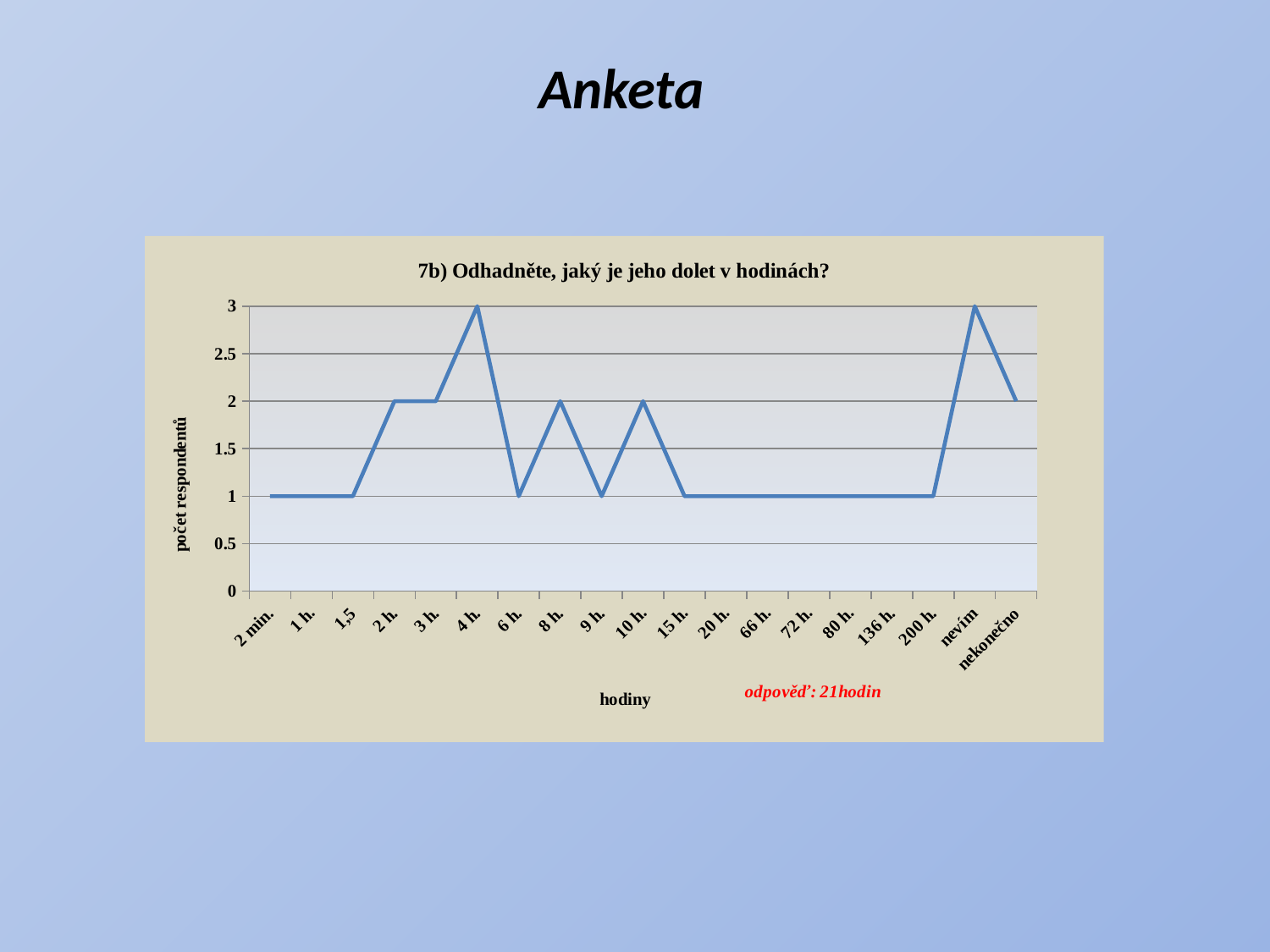
What type of chart is shown on the slide? line chart What is the value for the category "nevím"? 3 How many categories are shown on the x axis of the chart? 19 What is the title of the chart? 7b) Odhadněte, jaký je jeho dolet v hodinách? Which has the larger value, "2 h." or "6 h."? 2 h. What is the value for the category "6 h."? 1 What is the label of the y axis? počet respondentů What is the value for the category "2 h."? 2 What is the value for the category "4 h."? 3 What is the highest value plotted on the chart? 3 What is the difference between the values for "4 h." and "6 h."? 2 What is the value for the category "nekonečno"? 2